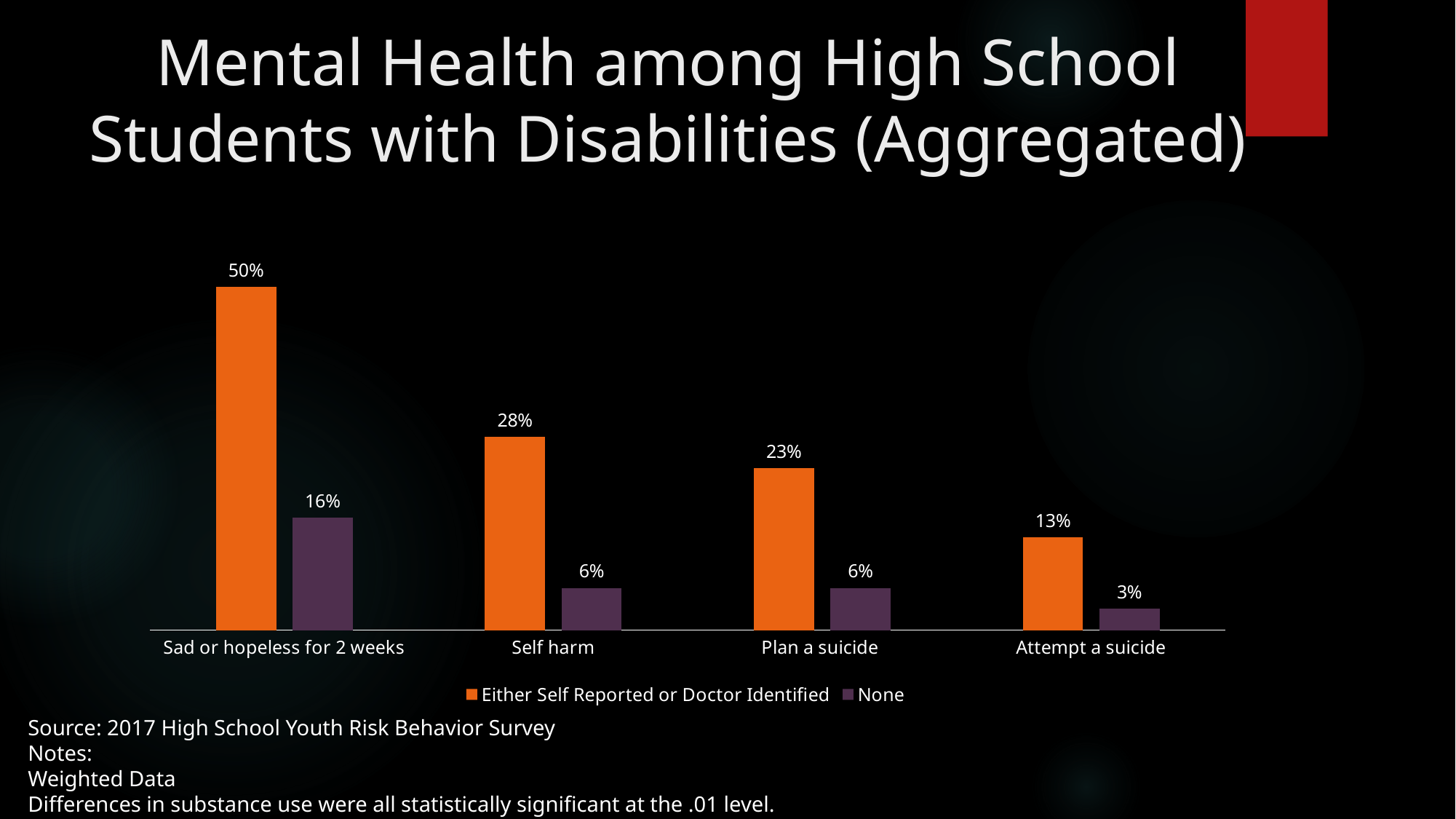
What kind of chart is shown on the slide? Bar chart What is the difference between the 'Either Self Reported or Doctor Identified' and 'None' values for 'Self harm'? 22% How many series does the legend list? 2 Which category has the highest value in the 'None' series? Sad or hopeless for 2 weeks Which category has the lowest value in the 'Either Self Reported or Doctor Identified' series? Attempt a suicide What is the value for 'Attempt a suicide' in the 'None' series? 3% How many categories are shown on the x axis? 4 What is the value for 'Plan a suicide' in the 'Either Self Reported or Doctor Identified' series? 23% What colour are the bars for the 'None' series? Purple What is the value for 'Sad or hopeless for 2 weeks' in the 'Either Self Reported or Doctor Identified' series? 50% Which is larger: the 'None' value for 'Sad or hopeless for 2 weeks' or the 'Either Self Reported or Doctor Identified' value for 'Attempt a suicide'? None value for Sad or hopeless for 2 weeks Do the values in the 'Either Self Reported or Doctor Identified' series rise or fall from left to right along the x axis? Fall